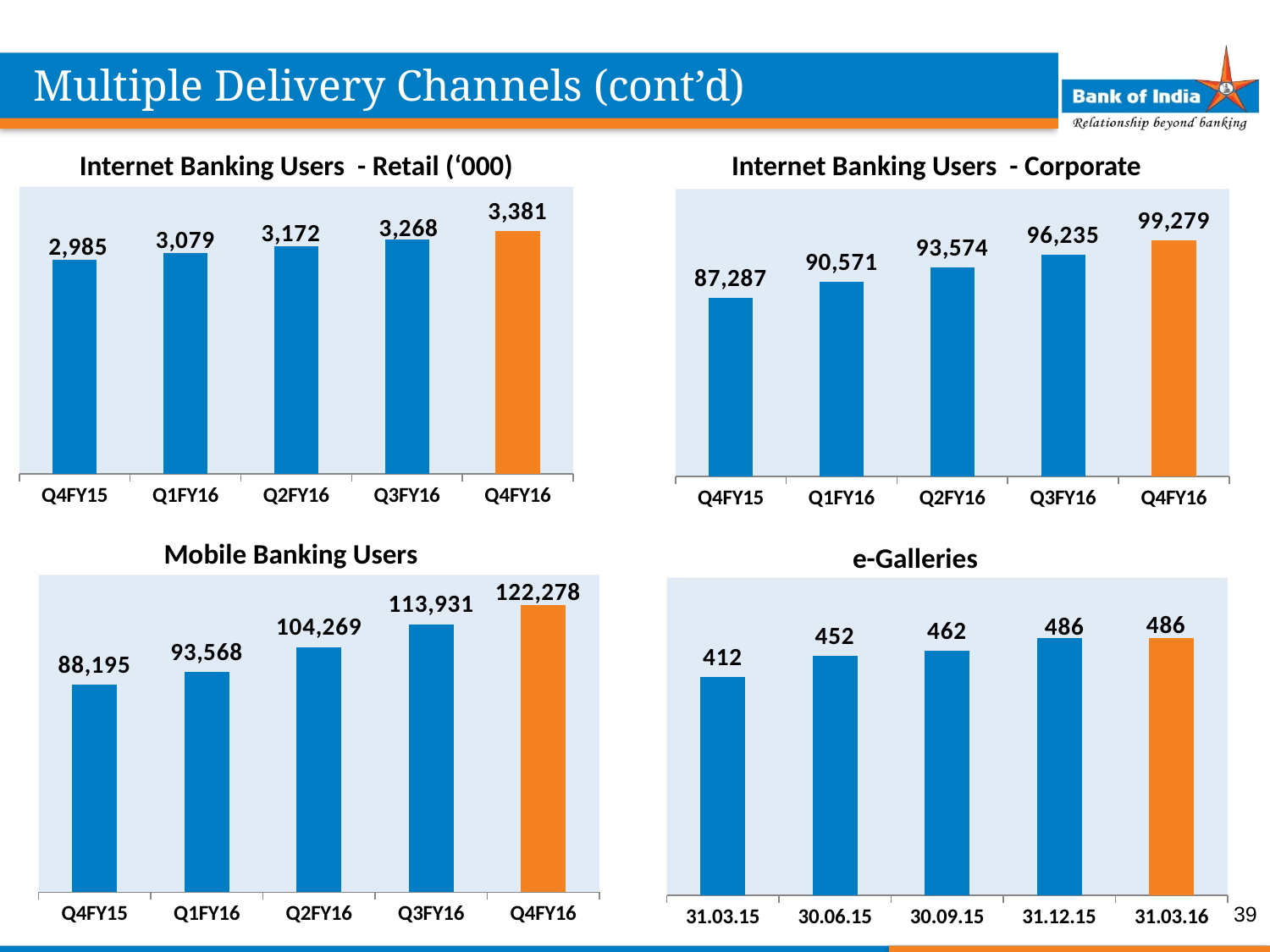
In the 'Mobile Banking Users' chart, which quarter has the lowest value? Q4FY15 In the 'e-Galleries' chart, what is the value for 30.06.15? 452 What type of chart is the 'Mobile Banking Users' chart? Bar chart In the 'Internet Banking Users - Retail ('000)' chart, do the values rise or fall from Q4FY15 to Q4FY16? Rise In the 'Internet Banking Users - Retail ('000)' chart, what is the value for Q2FY16? 3,172 In the 'Internet Banking Users - Corporate' chart, what is the value for Q4FY15? 87,287 In the 'Internet Banking Users - Corporate' chart, which quarter has the highest value? Q4FY16 In the 'Internet Banking Users - Retail ('000)' chart, what is the difference between the Q4FY16 and Q4FY15 values? 396 In the 'Mobile Banking Users' chart, what is the value for Q3FY16? 113,931 In the 'Mobile Banking Users' chart, what is the difference between the Q4FY16 and Q3FY16 values? 8,347 How many bars are shown in the 'Internet Banking Users - Corporate' chart? 5 In the 'e-Galleries' chart, which is larger: the value for 30.09.15 or the value for 31.12.15? 31.12.15